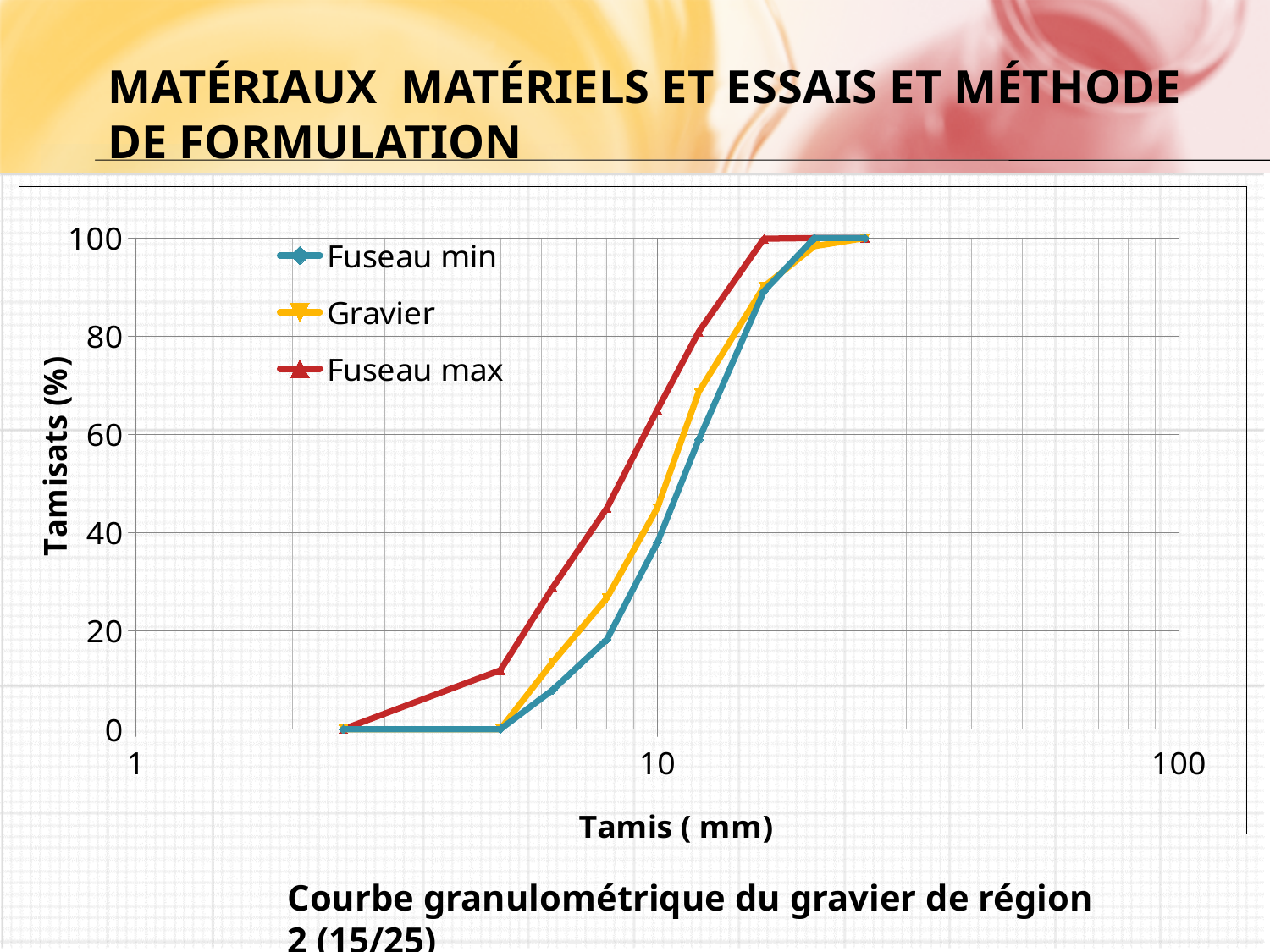
What are the names of the series listed in the legend? Fuseau min, Gravier, Fuseau max What kind of chart is shown on the slide? line chart How many series does the legend list? 3 At a sieve size of 10 mm, is the value for Gravier greater or less than 20? greater At a sieve size of 10 mm, which series has the larger value, Fuseau max or Fuseau min? Fuseau max Do the values of the Gravier series rise or fall as the sieve size (Tamis) increases along the x axis? rise At a sieve size of 10 mm, is the value for Fuseau min greater or less than 60? less At a sieve size of 10 mm, which of the three series has the lowest value? Fuseau min At a sieve size of 10 mm, which of the three series has the highest value? Fuseau max At a sieve size of 10 mm, is the value for Fuseau max greater or less than 60? greater What is the title of the vertical axis? Tamisats (%)